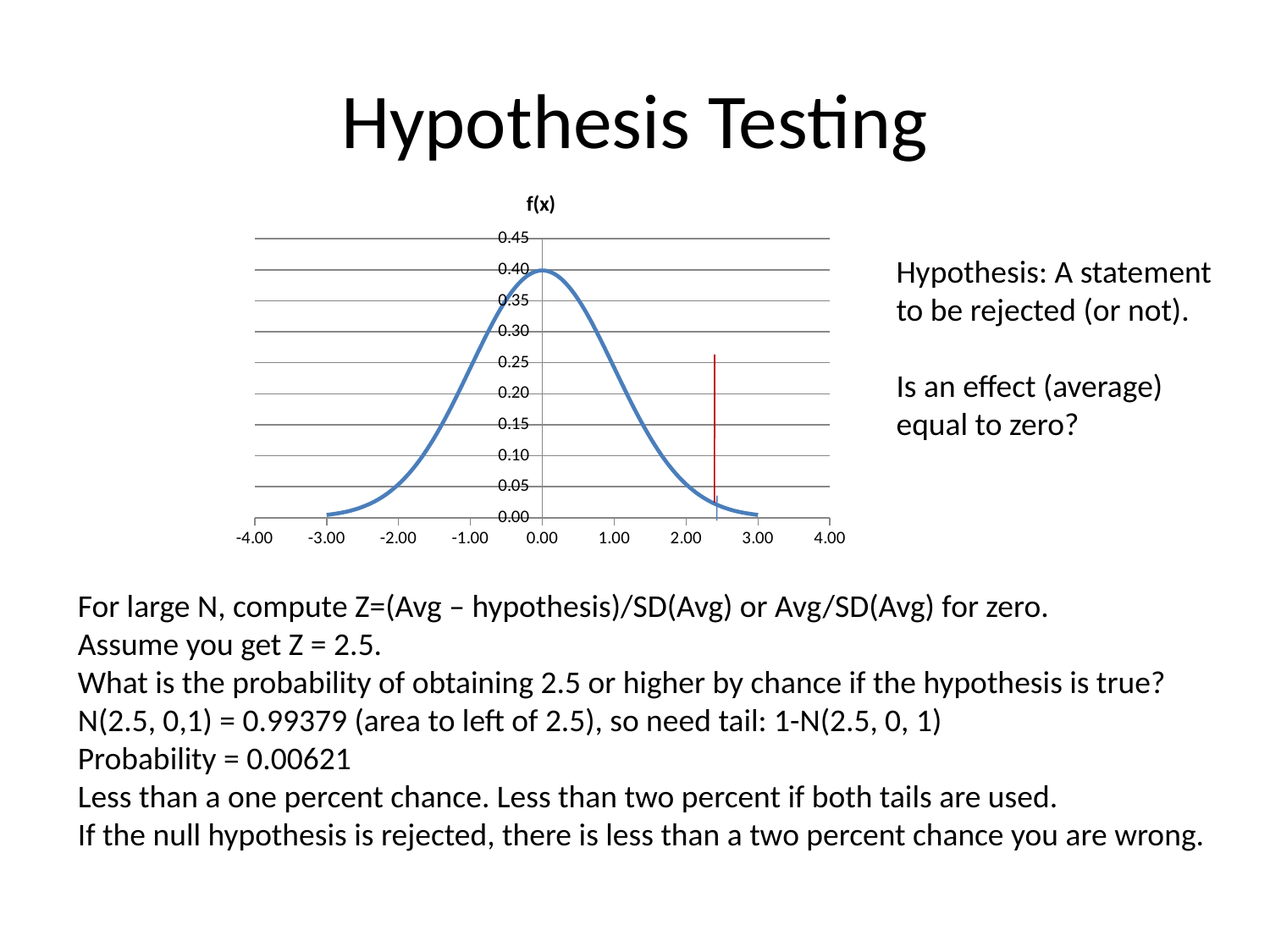
Is the value of the curve at x = 1.00 greater or less than 0.20? greater What is the highest tick label shown on the vertical axis? 0.45 At which x value does the curve reach its highest point? 0.00 What is the title of the chart? f(x) Which is larger, the value of the curve at x = 1.00 or at x = 2.00? x = 1.00 How many tick labels are shown on the horizontal axis? 9 Is the value of the curve at x = -3.00 greater or less than 0.05? less Does the curve rise or fall as x goes from -3.00 to 0.00? rise Is the value of the curve at x = 2.00 greater or less than 0.10? less What kind of chart is shown on the slide? line chart Does the curve rise or fall as x goes from 0.00 to 3.00? fall